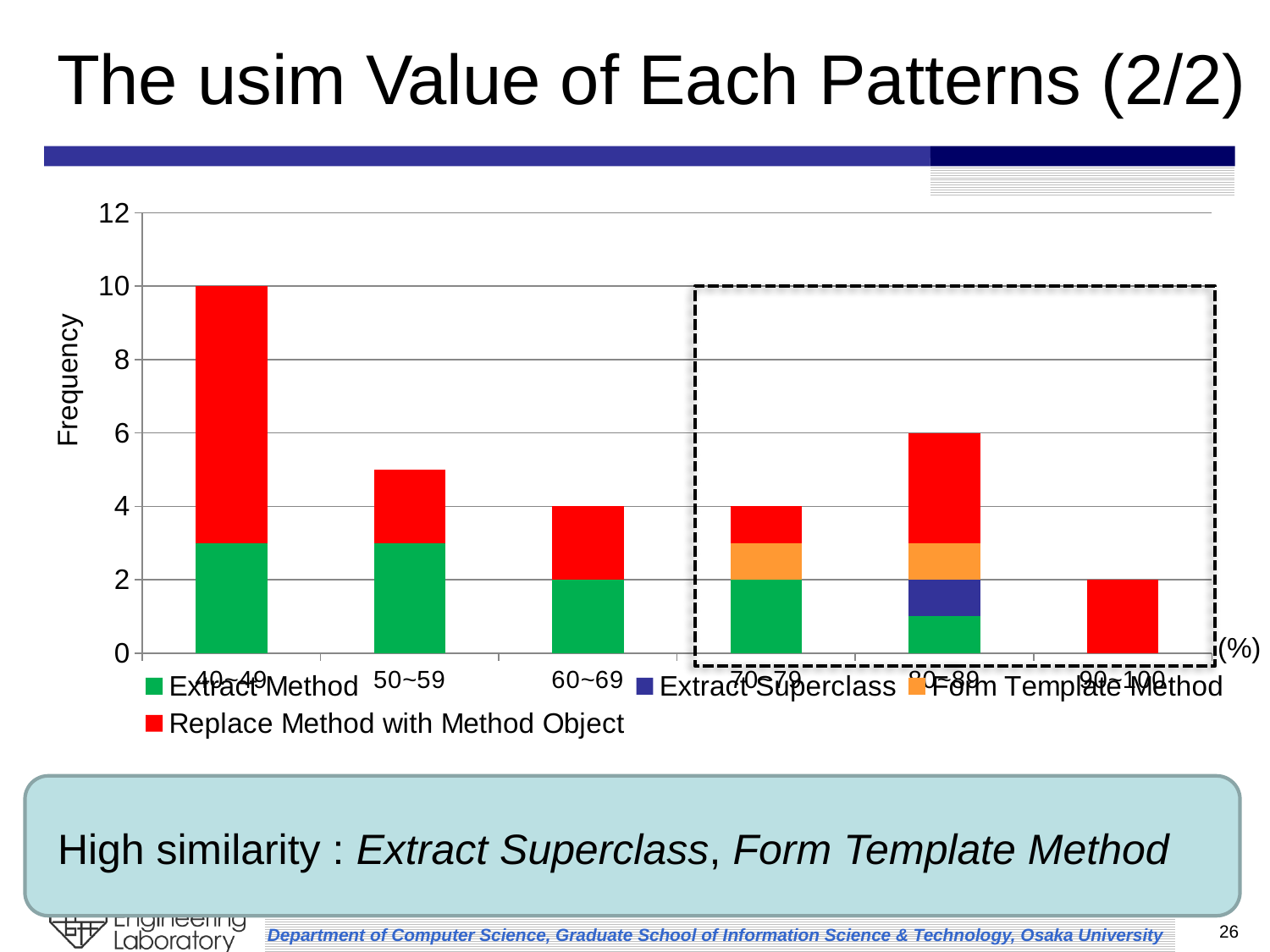
How many series does the chart's legend list? 4 What is the label of the y axis? Frequency What is the frequency of Extract Method in the 60~69 category? 2 Which category has the lowest total frequency? 90~100 Is the total frequency for 50~59 greater or less than 4? greater Which has the larger total frequency, 70~79 or 80~89? 80~89 What is the total frequency of the 40~49 bar? 10 How many categories are shown on the x axis of the chart? 6 What kind of chart is shown on the slide? Stacked bar chart Which category has the highest total frequency? 40~49 What is the total frequency of the 80~89 bar? 6 Which category is the only one that includes Extract Superclass? 80~89